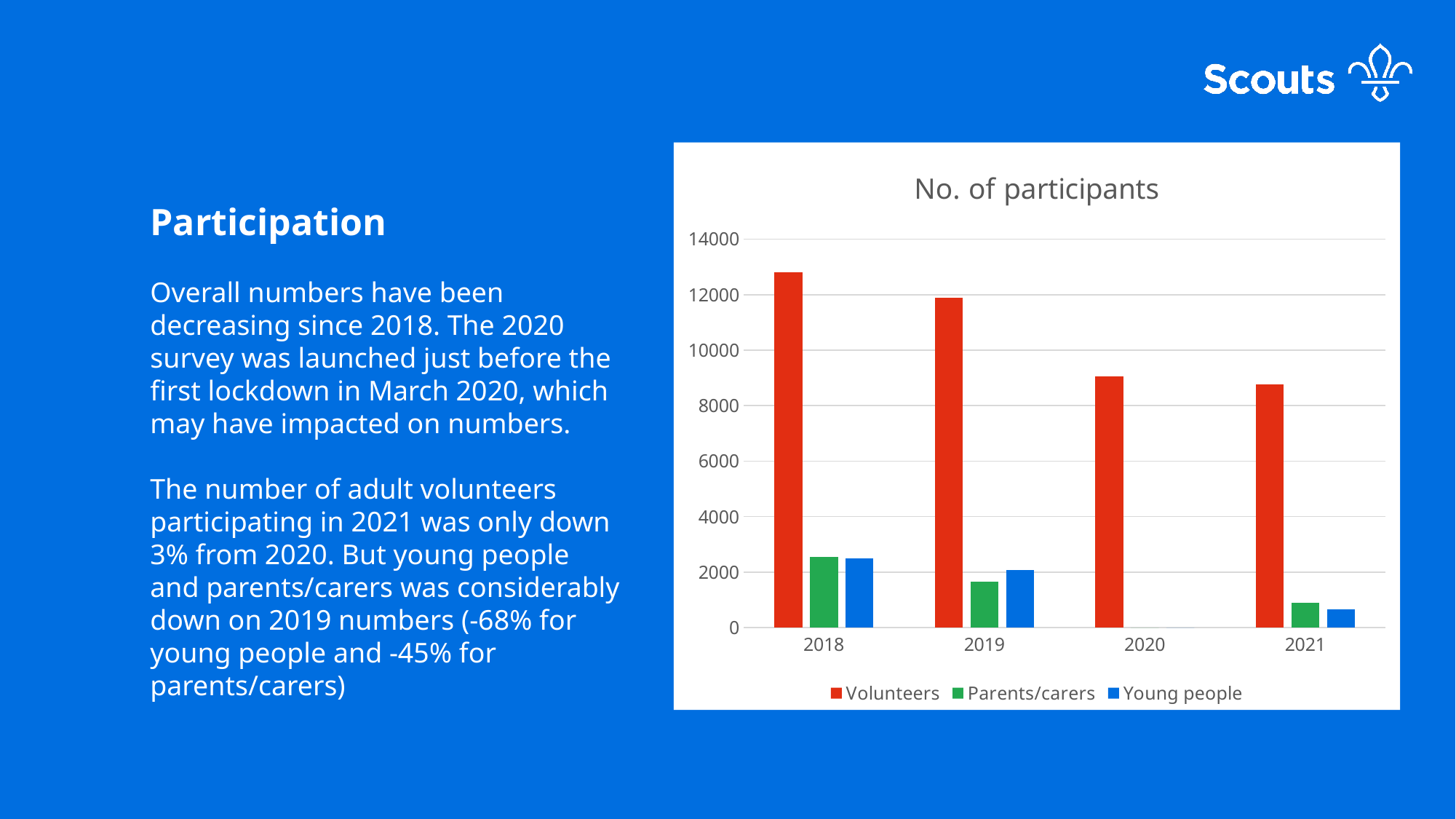
Is the value for Volunteers in 2021 greater or less than 8000? greater How many years are shown on the x axis of the chart? 4 Do the values for Volunteers rise or fall from 2018 to 2021? Fall Which colour represents Young people in the chart? Blue Is the value for Young people in 2021 greater or less than 1000? less Is the value for Volunteers in 2018 greater or less than 12000? greater How many series does the chart's legend list? 3 Which year has the highest value for Volunteers? 2018 What is the title of the chart? No. of participants What kind of chart is shown on the slide? Bar chart